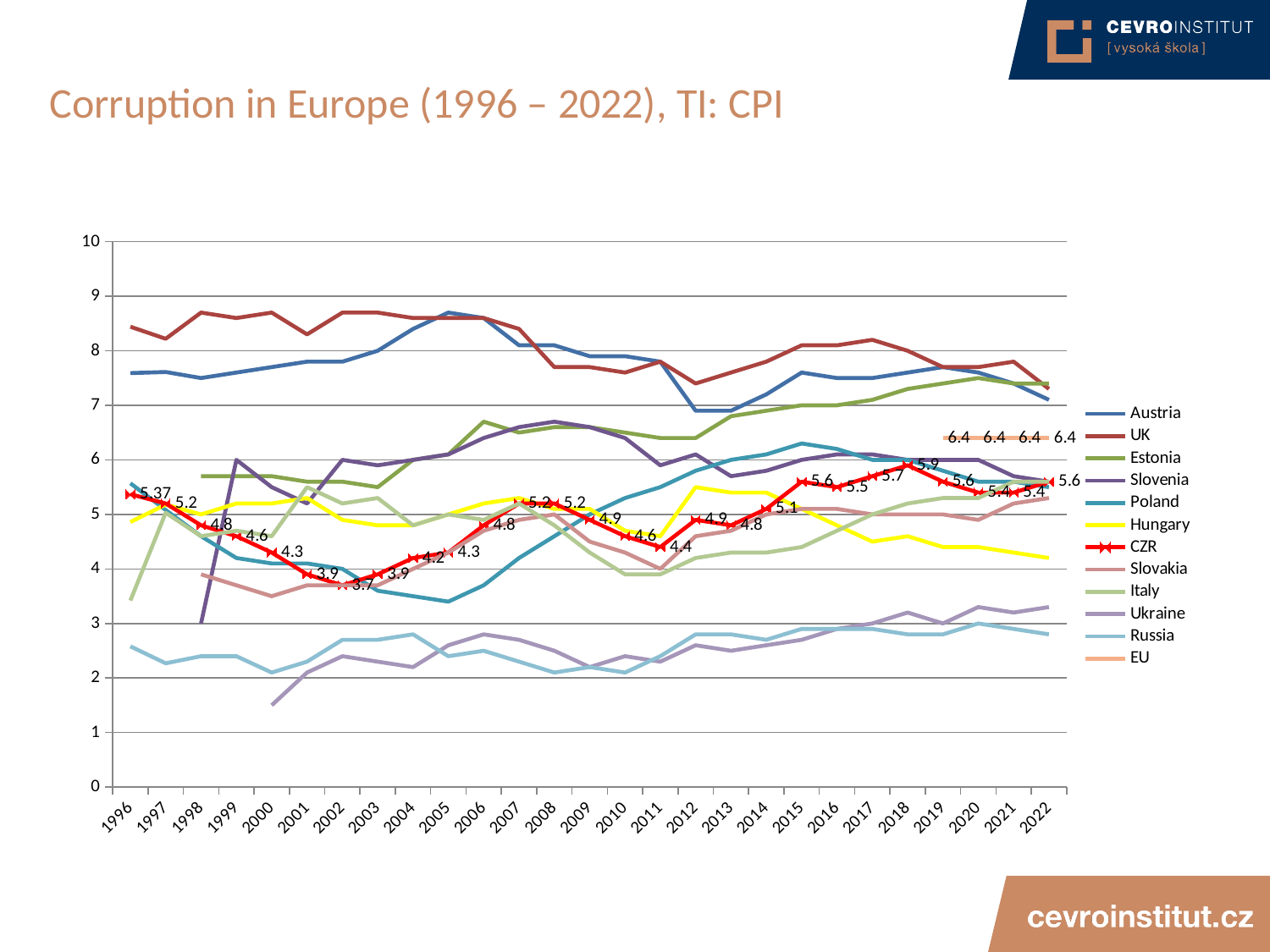
Is the value for UK in 1996 greater or less than 8? greater What is the CZR value for 2002? 3.7 What is the CZR value for 1996? 5.37 How many series does the legend list? 12 Is the value for Russia in 2022 greater or less than 3? less Does the CZR series rise or fall between 2000 and 2002? fall What is the EU value for 2022? 6.4 What is the CZR value for 2018? 5.9 What kind of chart is shown on the slide? line chart What is the difference between the CZR value in 2018 and the CZR value in 2002? 2.2 Which is larger, the CZR value in 2015 or the CZR value in 2016? 2015 In which year does the CZR series reach its lowest labelled value? 2002